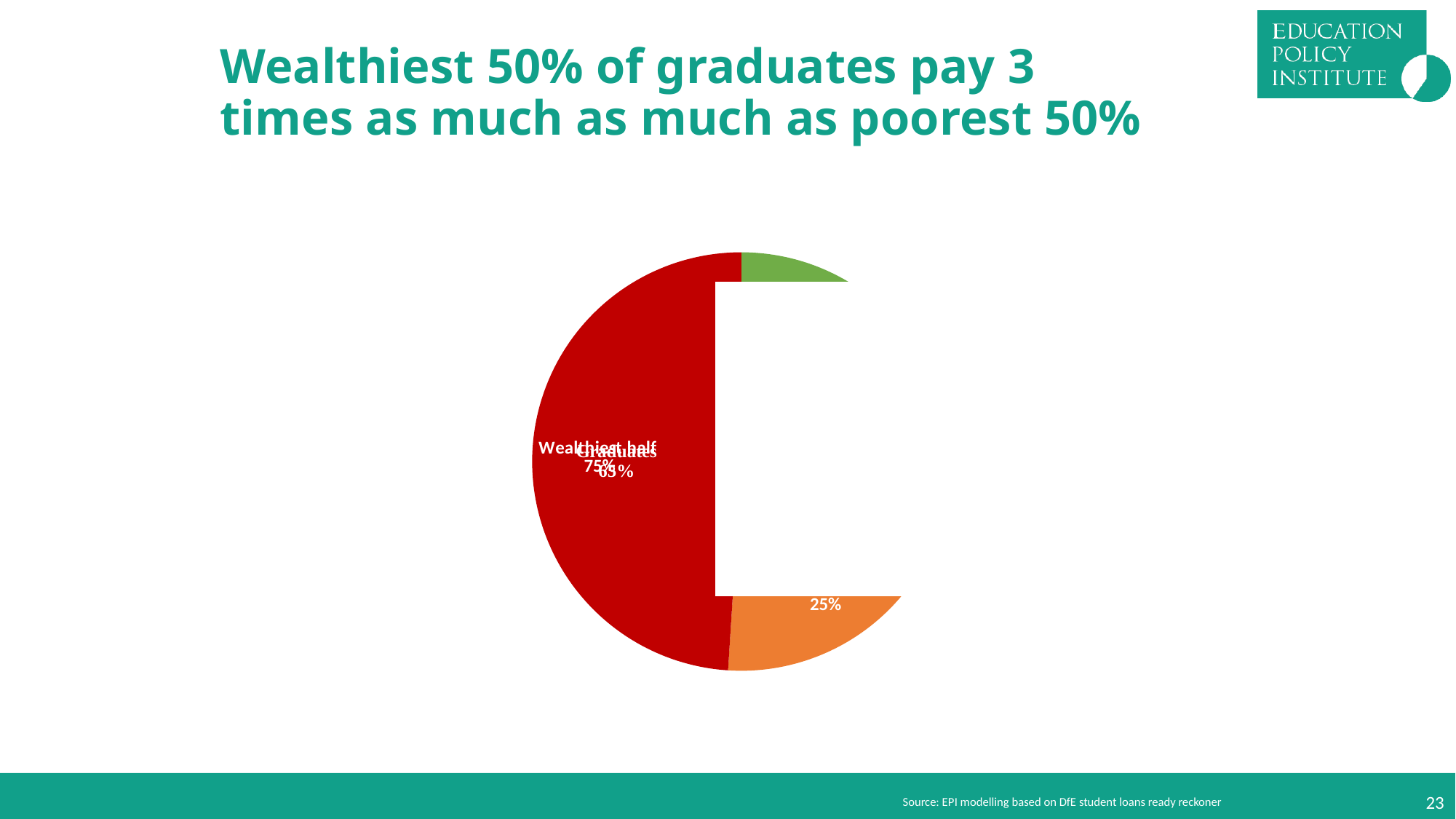
Which slice of the pie chart is the largest? the red slice What kind of chart is shown on the slide? pie chart What colour is the largest slice of the pie chart? red What is the title of the slide containing the pie chart? Wealthiest 50% of graduates pay 3 times as much as much as poorest 50% What percentage is printed on the orange slice of the pie chart? 25% Is the red slice of the pie chart larger or smaller than the orange slice? larger Which slice of the pie chart is the smallest? the green slice